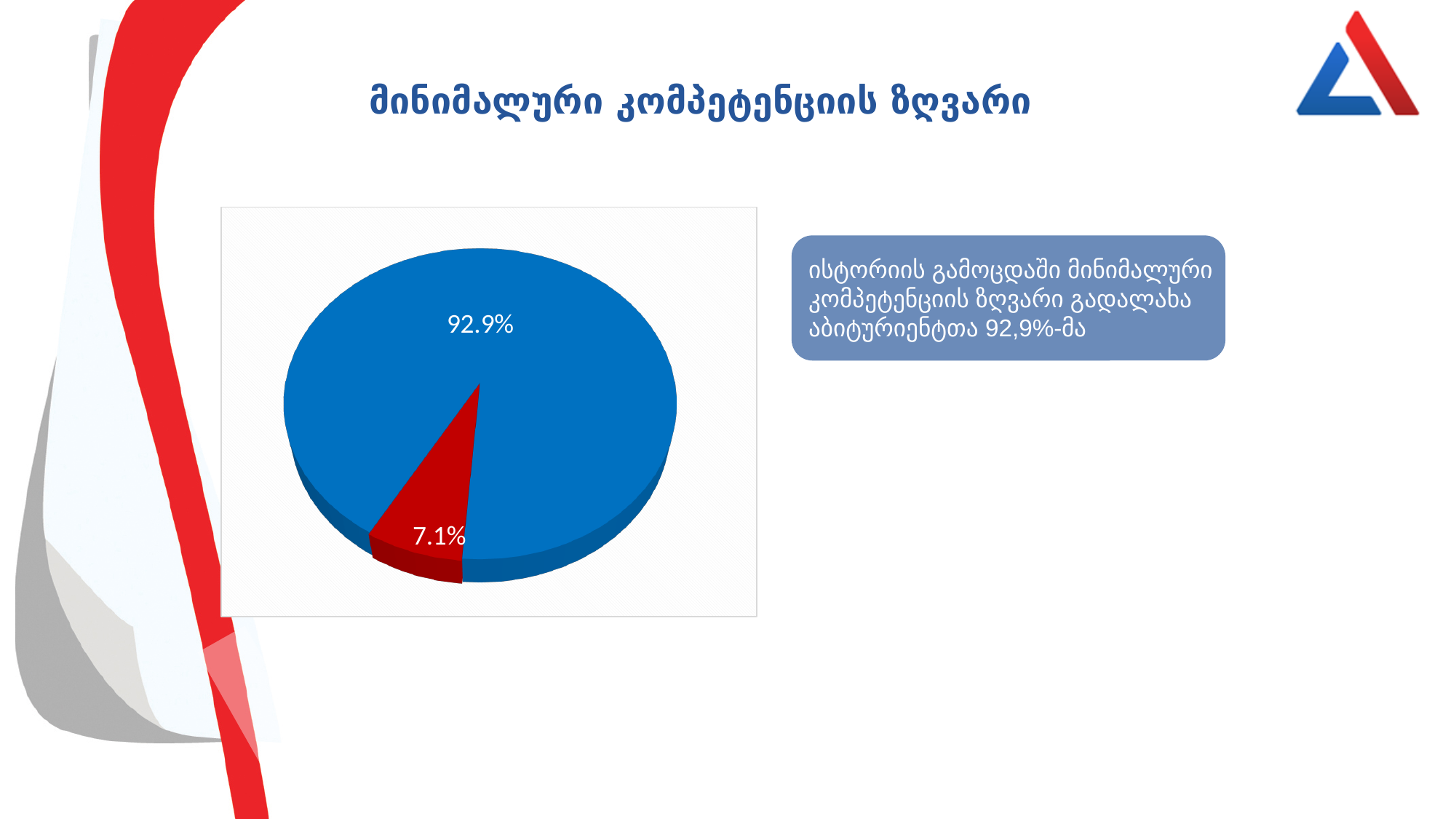
Is the value of the blue slice greater or less than 90%? greater What value is shown on the red slice of the pie chart? 7.1% How many slices does the pie chart have? 2 Which slice of the pie chart is the smallest? the red slice (7.1%) What is the title of the slide containing the pie chart? მინიმალური კომპეტენციის ზღვარი What kind of chart is shown on the slide? pie chart What value is shown on the blue slice of the pie chart? 92.9% What colour is the slice labelled 7.1% in the pie chart? red What is the difference between the blue slice and the red slice of the pie chart? 85.8% Which slice of the pie chart is the largest? the blue slice (92.9%) What share of the pie does the red slice represent? 7.1% Which is larger in the pie chart, the blue slice or the red slice? the blue slice